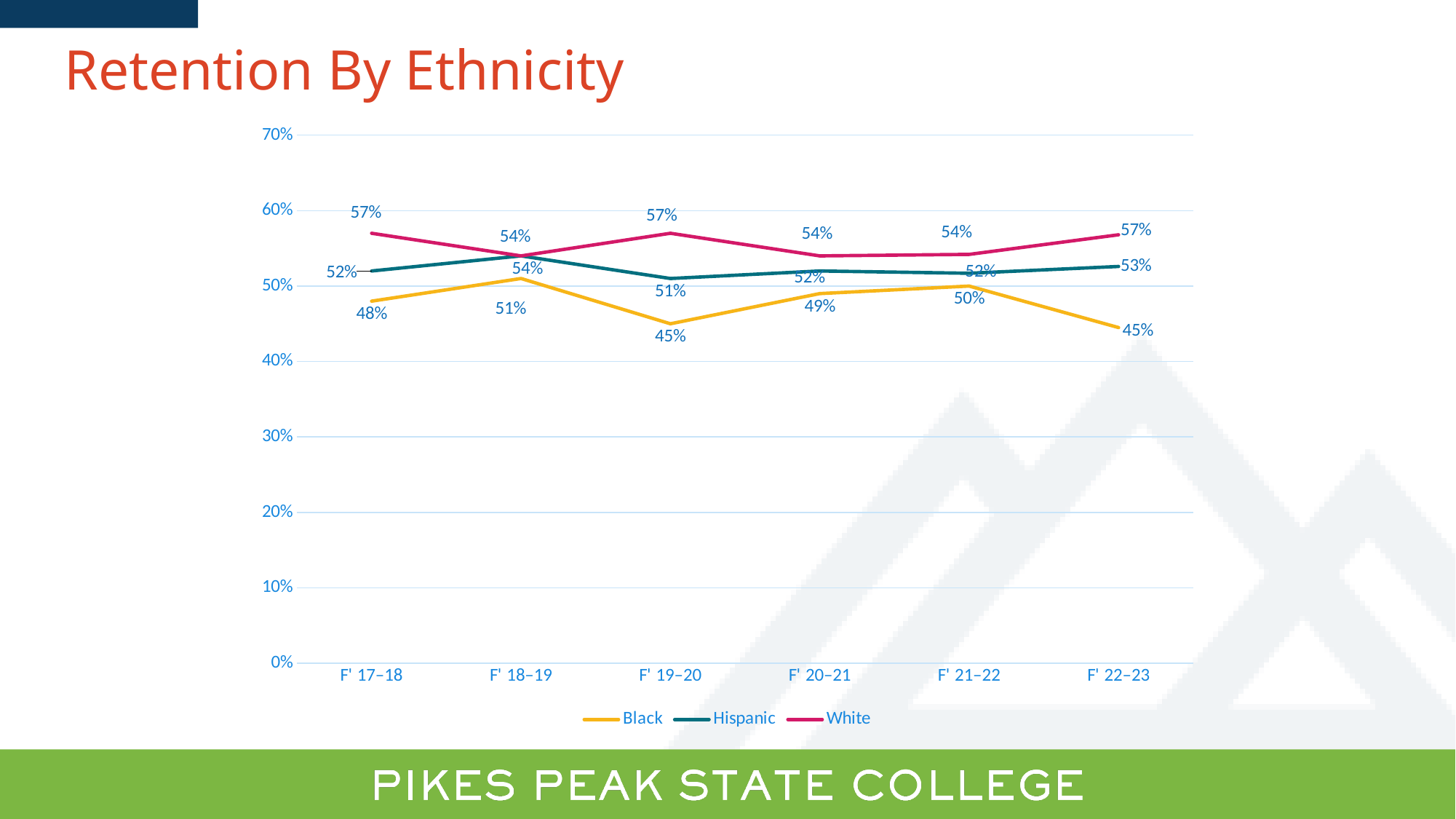
How many series does the legend list? 3 What type of chart is shown on the slide? line chart In which term is the retention rate for Hispanic students lowest? F' 19–20 What is the retention rate for White students in F' 20–21? 54% How many terms are shown along the x axis? 6 Which group has the higher retention rate in F' 17–18, Black or Hispanic? Hispanic What is the title of the chart? Retention By Ethnicity What is the difference between the White and Black retention rates in F' 22–23? 12% What is the retention rate for Hispanic students in F' 22–23? 53% What is the retention rate for Black students in F' 19–20? 45% In which term is the retention rate for Black students highest? F' 18–19 Is the retention rate for Black students in F' 21–22 greater or less than 40%? greater